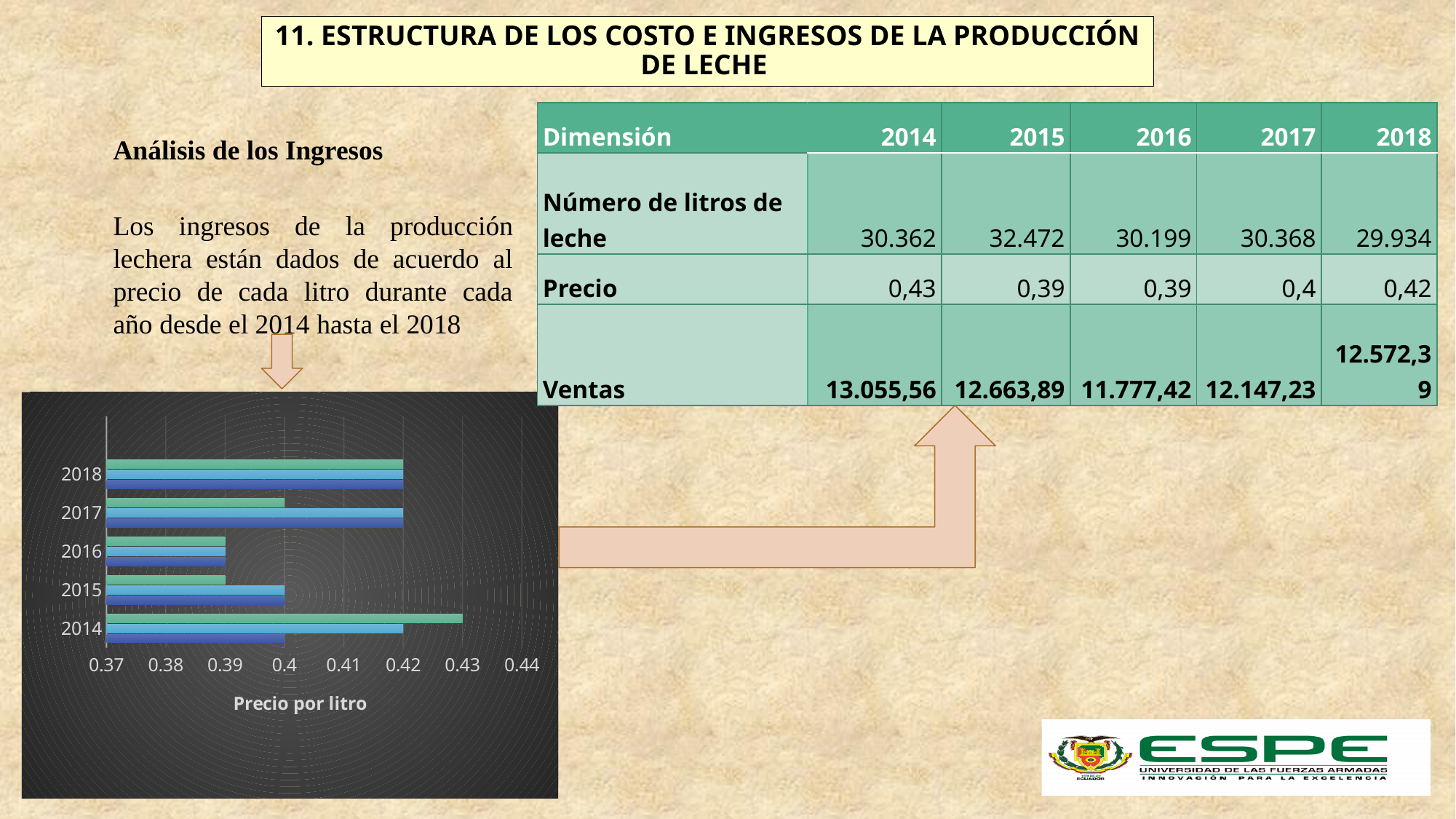
Which year has longer bars overall, 2018 or 2016? 2018 What kind of chart is shown on the slide? bar chart Are the bars for 2016 greater or less than 0.40? less Is the longest bar for 2015 greater or less than 0.41? less How many bars are drawn for each year in the bar chart? 3 Are the bars for 2018 greater or less than 0.41? greater Which year has the longest bar in the bar chart? 2014 What is the lowest value shown on the horizontal axis of the bar chart? 0.37 How many years are shown on the vertical axis of the bar chart? 5 What is the title of the horizontal axis of the bar chart? Precio por litro Which year has a longer longest bar, 2014 or 2017? 2014